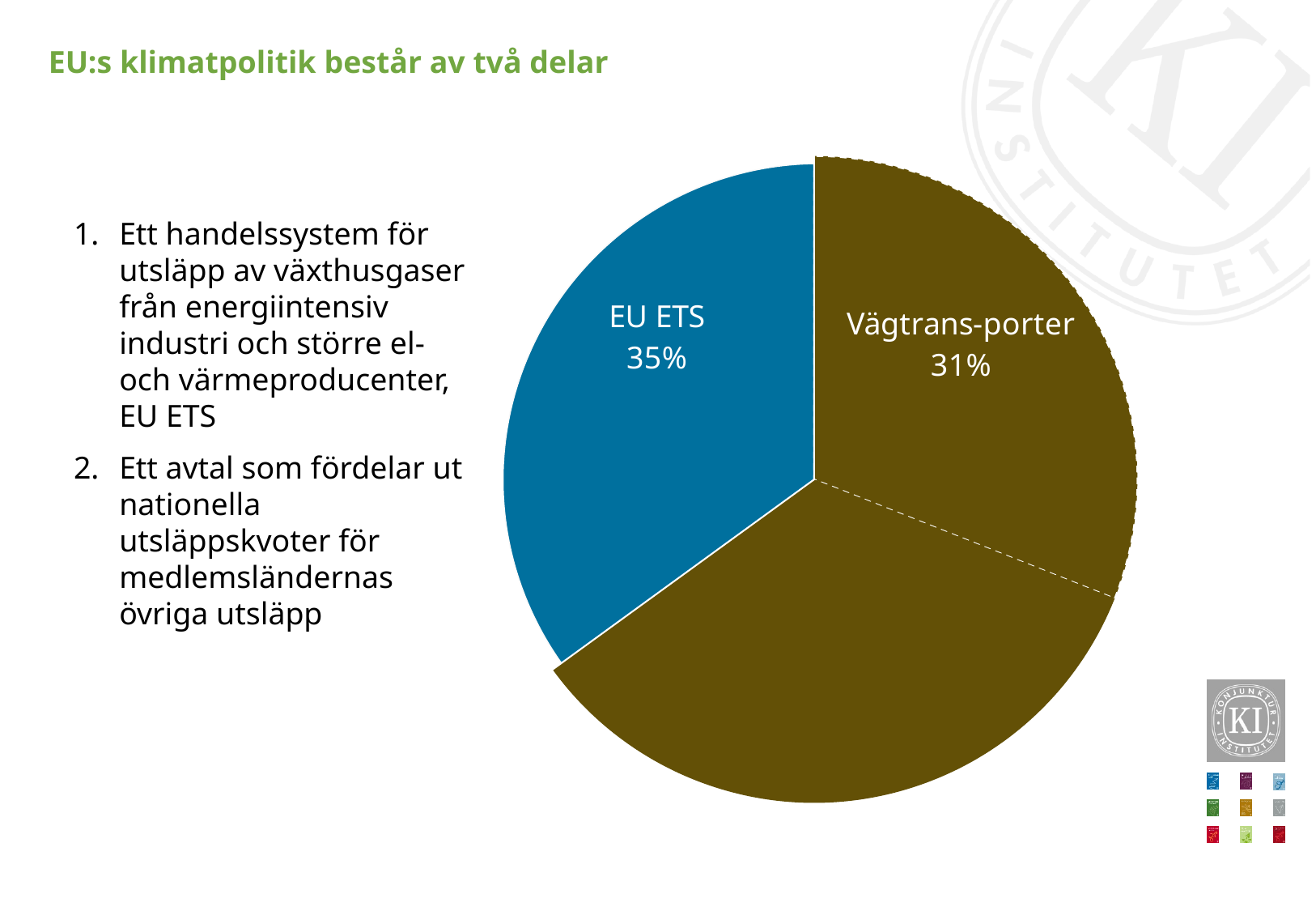
What percentage does the EU ETS slice of the pie chart represent? 35% By how many percentage points does the EU ETS slice exceed the Vägtransporter slice? 4 percentage points What percentage does the Vägtransporter slice of the pie chart represent? 31% What kind of chart is shown on the slide? Pie chart How many slices of the pie chart have a printed label? 2 Which slice is larger in the pie chart, EU ETS or Vägtransporter? EU ETS What is the title of the slide containing the pie chart? EU:s klimatpolitik består av två delar What colour is the EU ETS slice in the pie chart? Blue